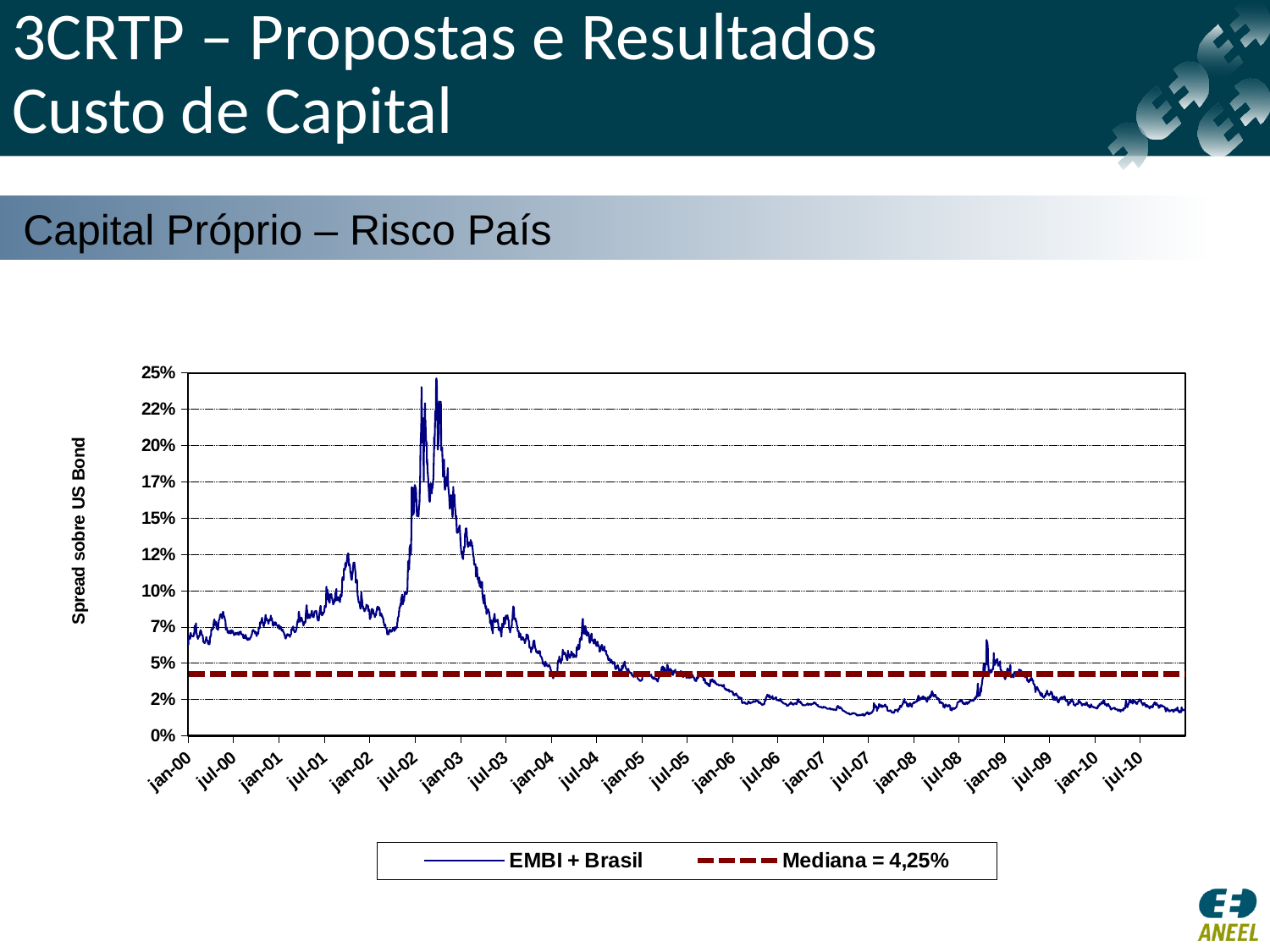
Is the highest peak of the EMBI + Brasil line greater or less than 20%? greater What is the label of the vertical axis? Spread sobre US Bond Which is higher, the EMBI + Brasil value at jan-00 or at jan-10? jan-00 Is the EMBI + Brasil value at jan-00 greater or less than 5%? greater Is the EMBI + Brasil value at jul-07 greater or less than 2%? less In which year does the EMBI + Brasil spread reach its highest peak? 2002 What kind of chart is shown on the slide? line chart How many series does the legend list? 2 What is the name of the solid line series in the legend? EMBI + Brasil Between jan-03 and jan-06, does the EMBI + Brasil spread generally rise or fall? fall What value does the legend give for the median (Mediana) line? 4,25%